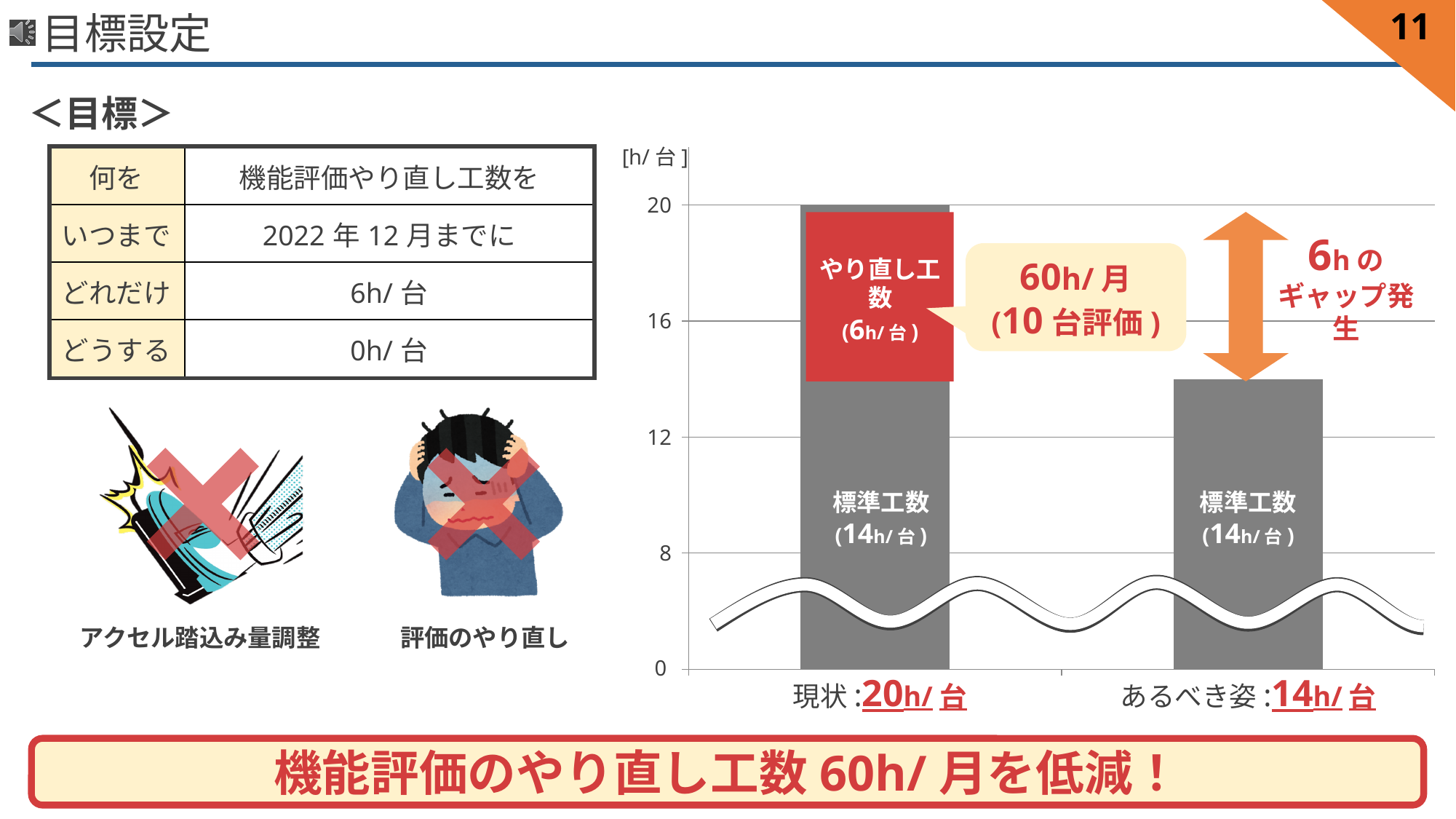
What unit is shown on the vertical axis of the chart? [h/台] What is the total value of the 現状 bar? 20h/台 What is the total value of the あるべき姿 bar? 14h/台 Which bar is taller, 現状 or あるべき姿? 現状 What is the value of the 標準工数 segment in the あるべき姿 bar? 14h/台 What kind of chart is shown on the slide? bar chart How many bars (categories) are plotted in the chart? 2 What colour is the やり直し工数 segment in the chart? red What is the value of the やり直し工数 segment in the 現状 bar? 6h/台 What is the value of the 標準工数 segment in the 現状 bar? 14h/台 What is the difference between the 現状 total and the あるべき姿 total? 6h/台 Is the value of the あるべき姿 bar greater or less than 16? less